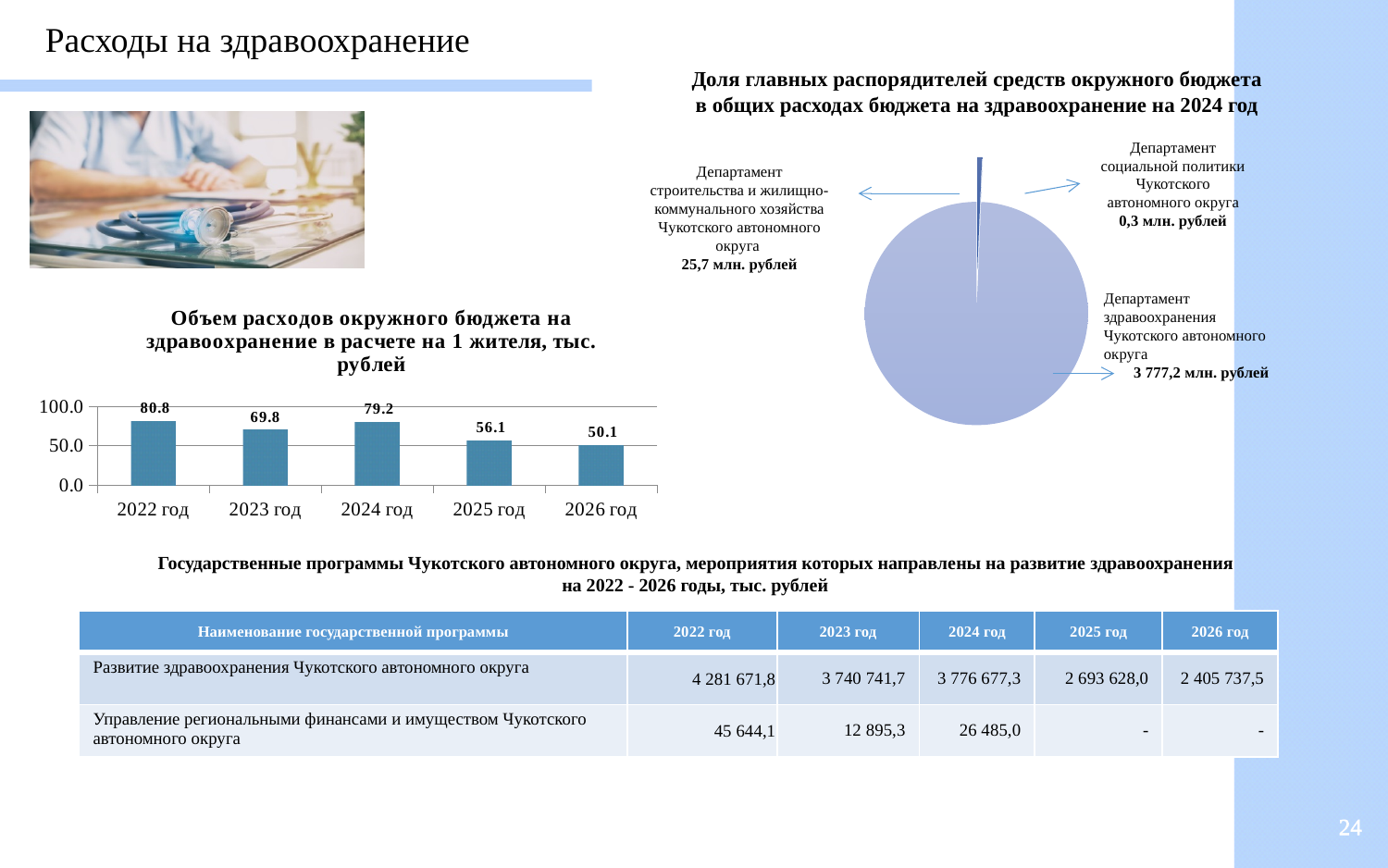
In the bar chart 'Объем расходов окружного бюджета на здравоохранение в расчете на 1 жителя, тыс. рублей', which year has the lowest value? 2026 год In the pie chart 'Доля главных распорядителей средств окружного бюджета в общих расходах бюджета на здравоохранение на 2024 год', which department has the smallest value? Департамент социальной политики Чукотского автономного округа In the bar chart 'Объем расходов окружного бюджета на здравоохранение в расчете на 1 жителя, тыс. рублей', which year has the highest value? 2022 год In the bar chart 'Объем расходов окружного бюджета на здравоохранение в расчете на 1 жителя, тыс. рублей', do the values rise or fall from 2024 год to 2026 год? fall In the bar chart 'Объем расходов окружного бюджета на здравоохранение в расчете на 1 жителя, тыс. рублей', what is the value for 2025 год? 56.1 In the pie chart 'Доля главных распорядителей средств окружного бюджета в общих расходах бюджета на здравоохранение на 2024 год', what is the value for Департамент здравоохранения Чукотского автономного округа? 3 777,2 млн. рублей In the pie chart 'Доля главных распорядителей средств окружного бюджета в общих расходах бюджета на здравоохранение на 2024 год', how many departments are shown? 3 What kind of chart is 'Объем расходов окружного бюджета на здравоохранение в расчете на 1 жителя, тыс. рублей'? bar chart In the bar chart 'Объем расходов окружного бюджета на здравоохранение в расчете на 1 жителя, тыс. рублей', which is larger: the value for 2023 год or 2024 год? 2024 год In the bar chart 'Объем расходов окружного бюджета на здравоохранение в расчете на 1 жителя, тыс. рублей', what is the difference between the values for 2022 год and 2026 год? 30.7 In the bar chart 'Объем расходов окружного бюджета на здравоохранение в расчете на 1 жителя, тыс. рублей', how many years are shown? 5 In the bar chart 'Объем расходов окружного бюджета на здравоохранение в расчете на 1 жителя, тыс. рублей', what is the value for 2022 год? 80.8